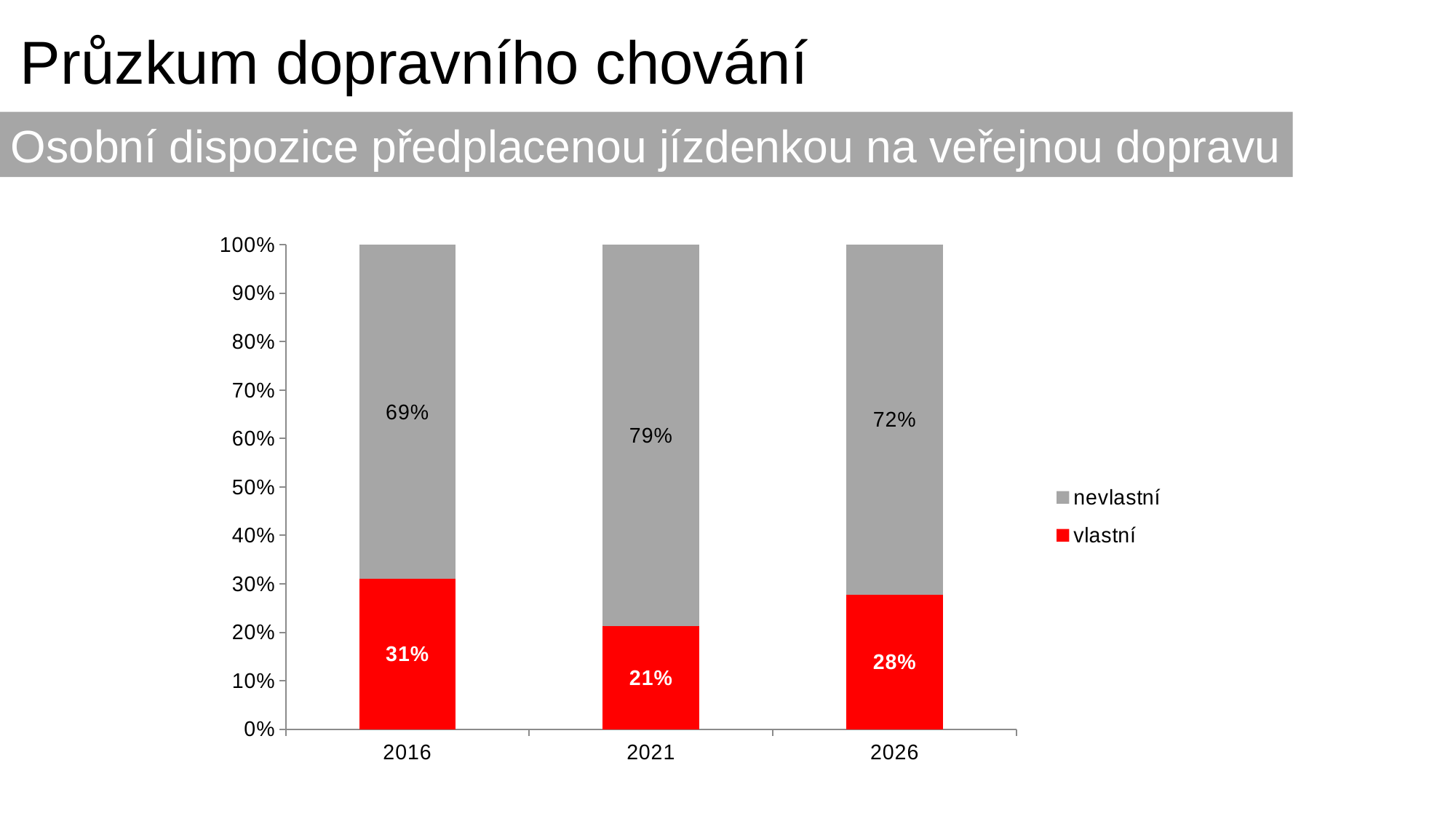
In which year is the 'vlastní' share lowest? 2021 What is the value for 'nevlastní' in 2021? 79% Which is larger, the 'vlastní' value for 2016 or for 2026? 2016 How many series does the legend list? 2 What is the value for 'vlastní' in 2016? 31% What is the value for 'vlastní' in 2026? 28% How many years are shown on the x axis? 3 What is the value for 'nevlastní' in 2026? 72% What kind of chart is shown on the slide? stacked bar chart Is the 'vlastní' value for 2021 greater or less than 30%? less In which year is the 'vlastní' share highest? 2016 What is the difference between the 'nevlastní' values for 2021 and 2016? 10%